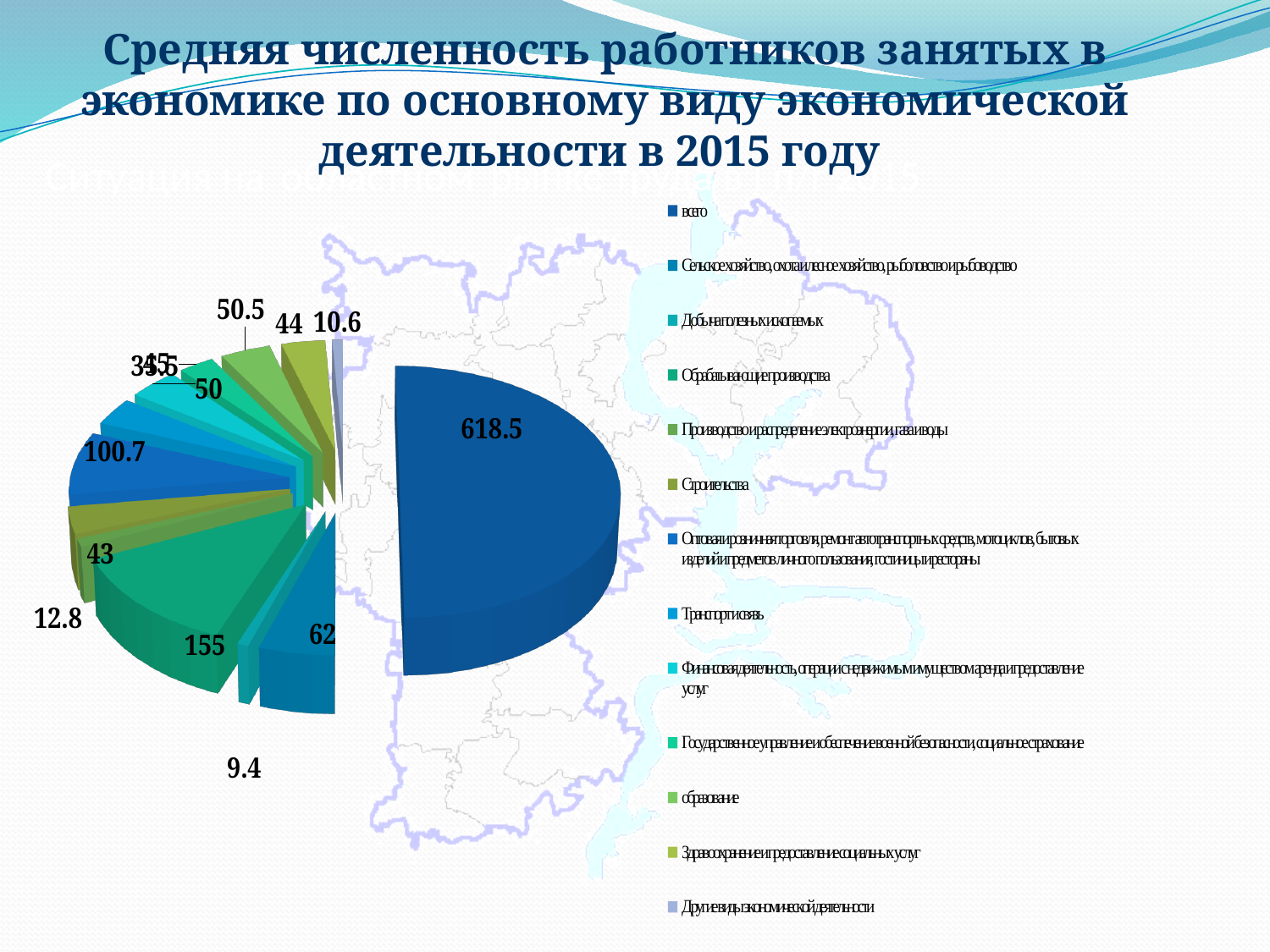
Which is larger: the slice labelled 12.8 or the slice labelled 10.6? 12.8 Which year does the chart title refer to? 2015 Which is larger: the slice labelled 155 or the slice labelled 100.7? 155 What is the first entry listed in the chart legend? всего What is the difference between the slices labelled 155 and 62? 93 What is the value of the largest slice in the pie chart? 618.5 What is the smallest value labelled on the pie chart? 9.4 What value is shown for the 'всего' (total) slice of the pie chart? 618.5 How many entries does the legend of the pie chart list? 13 What is the difference between the slice labelled 618.5 and the slice labelled 155? 463.5 What type of chart is shown on the slide? Pie chart What is the difference between the slices labelled 50.5 and 44? 6.5